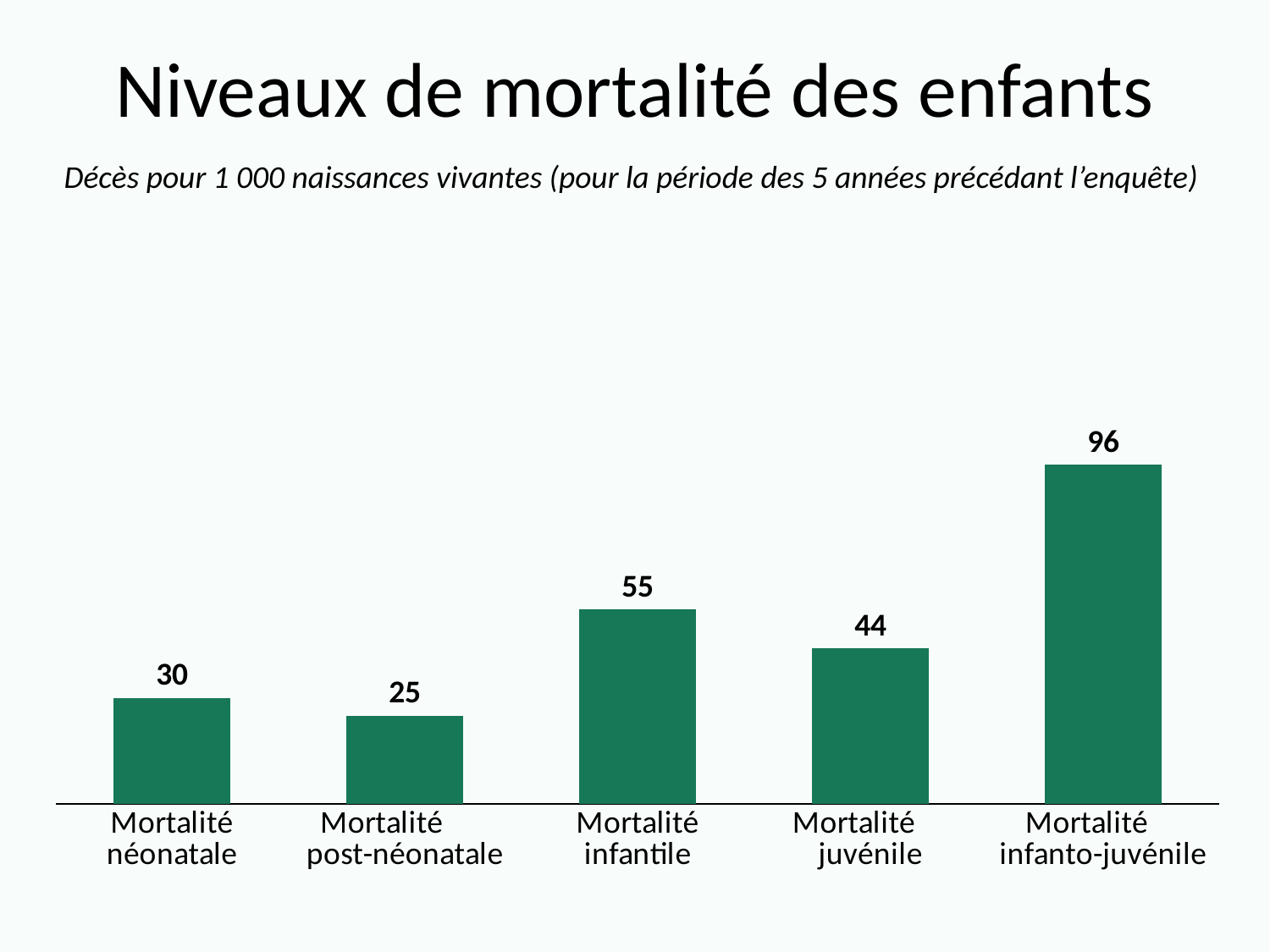
What is the title of the slide? Niveaux de mortalité des enfants What kind of chart is shown on the slide? Bar chart What is the value for Mortalité néonatale? 30 Which is larger, the value for Mortalité infantile or the value for Mortalité juvénile? Mortalité infantile What is the value for Mortalité infanto-juvénile? 96 What is the value for Mortalité infantile? 55 What is the value for Mortalité juvénile? 44 How many categories are shown in the chart? 5 What is the value for Mortalité post-néonatale? 25 Which category has the lowest value? Mortalité post-néonatale Which category has the highest value? Mortalité infanto-juvénile What is the difference between the values for Mortalité infanto-juvénile and Mortalité infantile? 41